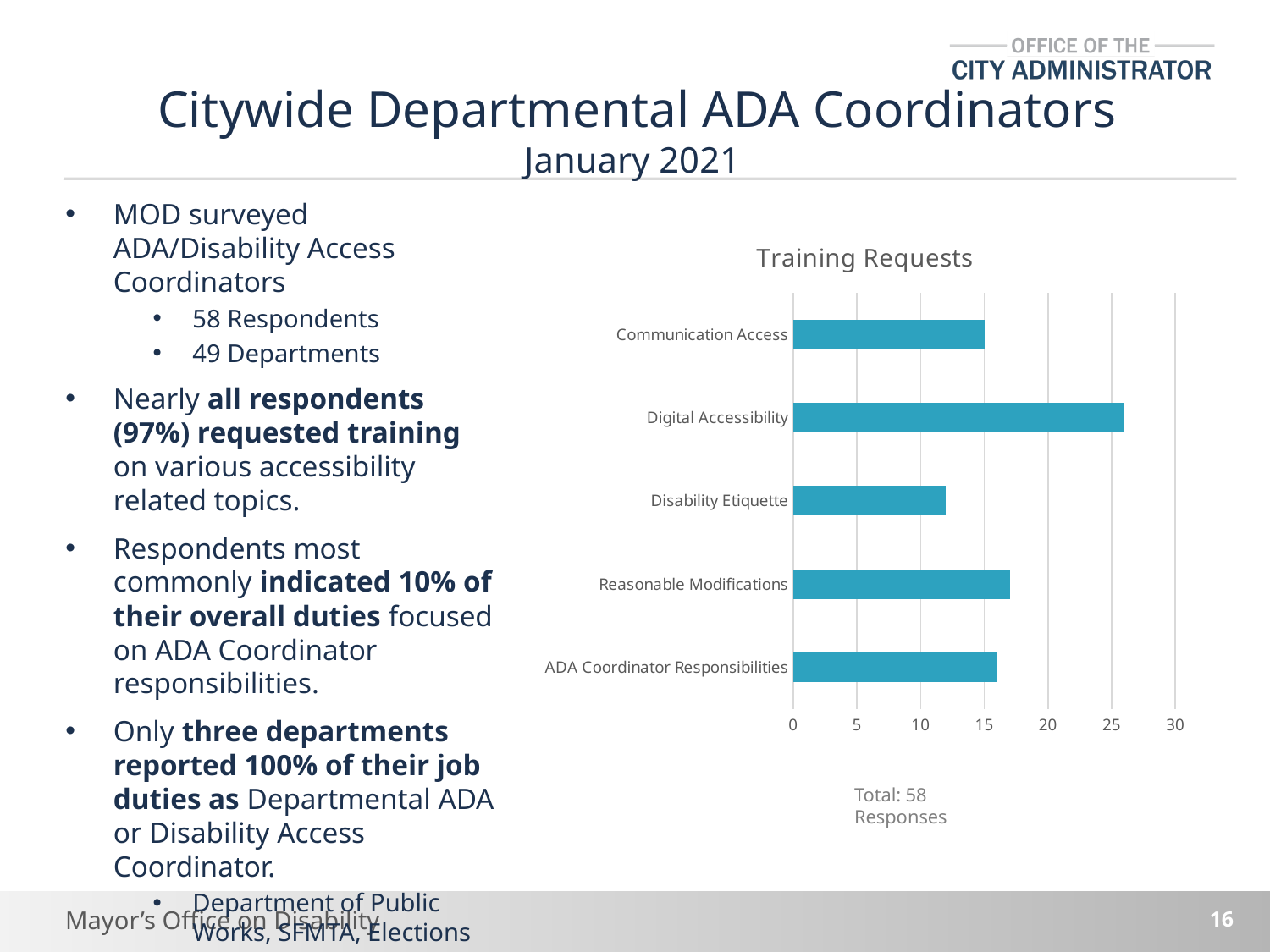
Is the value for Communication Access greater or less than 20? less How many categories are shown in the Training Requests chart? 5 Is the value for Disability Etiquette greater or less than 15? less Which category has the highest value in the Training Requests chart? Digital Accessibility Which has a larger value, Digital Accessibility or Communication Access? Digital Accessibility Which category has the lowest value in the Training Requests chart? Disability Etiquette Is the value for Digital Accessibility greater or less than 25? greater Which has a larger value, Reasonable Modifications or Disability Etiquette? Reasonable Modifications What is the highest value shown on the horizontal axis of the chart? 30 What type of chart is shown on the slide? Bar chart What is the title of the chart? Training Requests